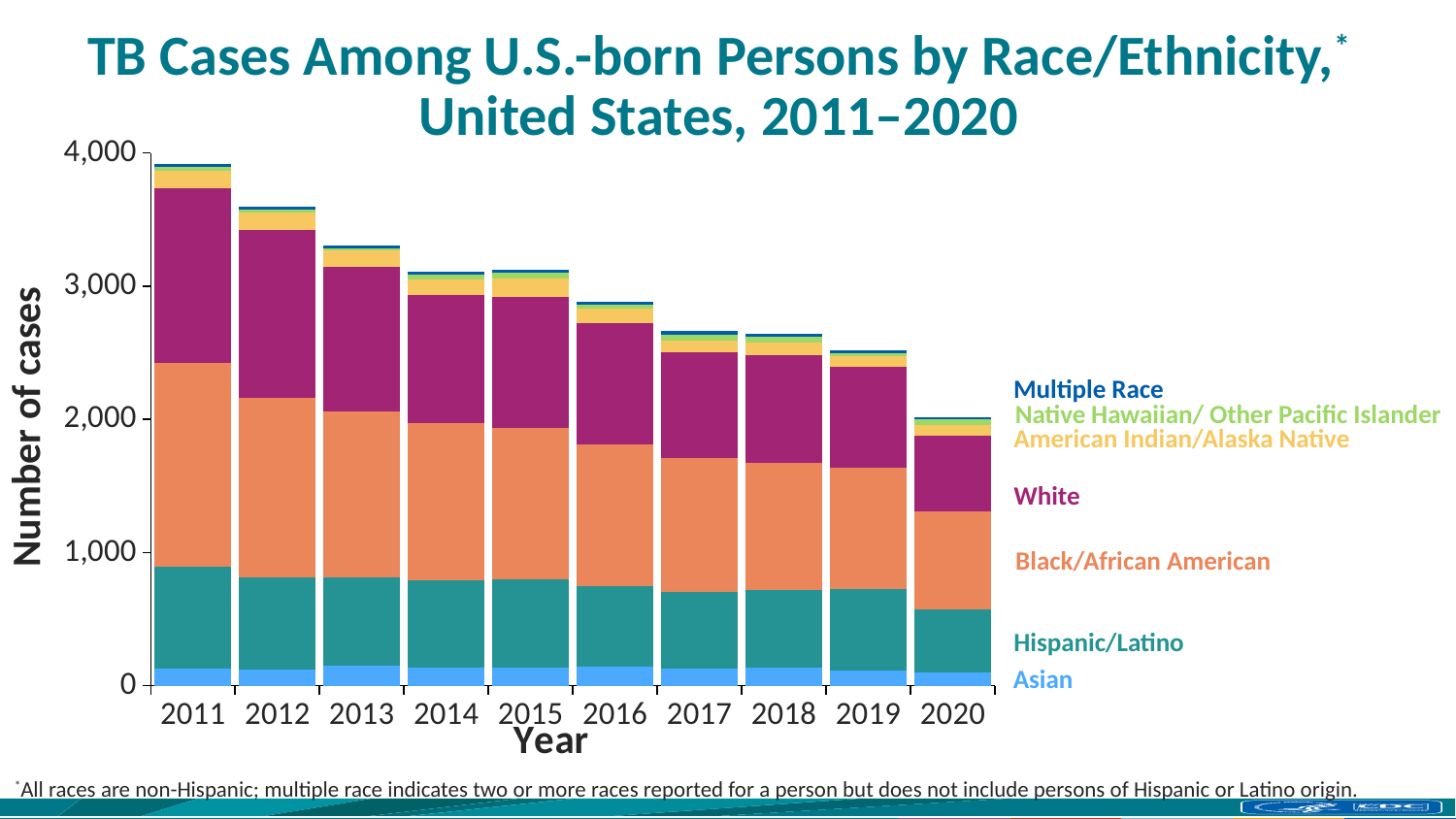
Is the total number of cases in 2016 greater or less than 3,000? less How many years are shown along the x axis of the chart? 10 Is the total number of cases in 2019 greater or less than 3,000? less Which year has a larger total number of cases, 2012 or 2018? 2012 What is the label on the y axis of the chart? Number of cases Which year has the lowest total number of TB cases? 2020 How many race/ethnicity series does the legend list? 7 Which race/ethnicity group is shown at the bottom of each stacked bar? Asian Which year has the highest total number of TB cases? 2011 Is the total number of cases in 2011 greater or less than 3,000? greater Do the total TB cases rise or fall from 2011 to 2020? fall What kind of chart is shown on the slide? Stacked bar chart